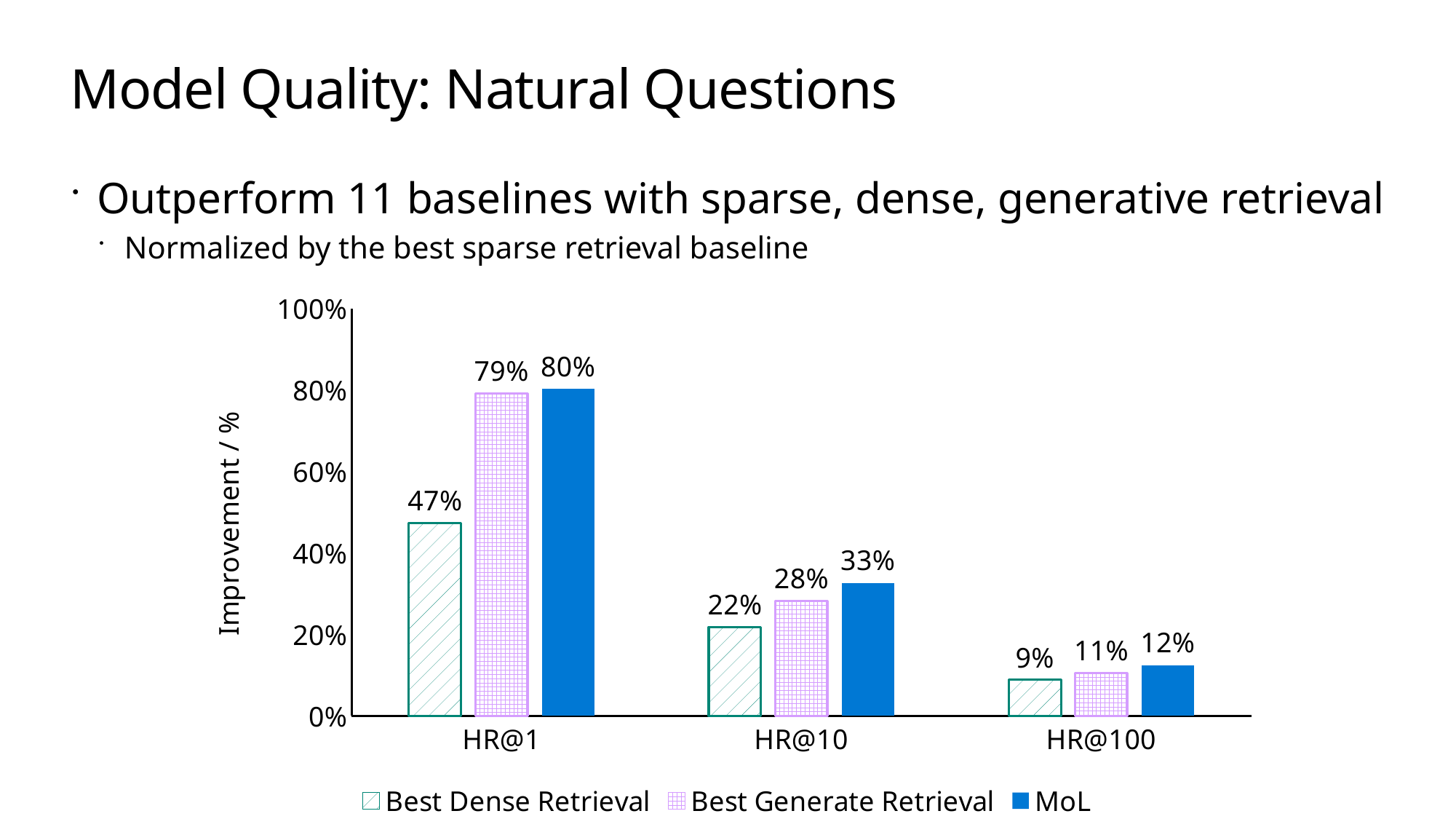
What is the improvement for Best Dense Retrieval at HR@10? 22% How many series does the legend list? 3 Which series has the highest improvement at HR@10? MoL Which series has the lowest improvement at HR@1? Best Dense Retrieval How many categories are shown on the x axis? 3 What is the difference between MoL and Best Dense Retrieval at HR@1? 33% What kind of chart is shown on the slide? Bar chart What is the improvement for Best Generate Retrieval at HR@100? 11% What is the difference between MoL and Best Generate Retrieval at HR@10? 5% What is the improvement for MoL at HR@1? 80% Which is larger: Best Generate Retrieval at HR@10 or Best Dense Retrieval at HR@10? Best Generate Retrieval at HR@10 Do the MoL values rise or fall from HR@1 to HR@100? Fall